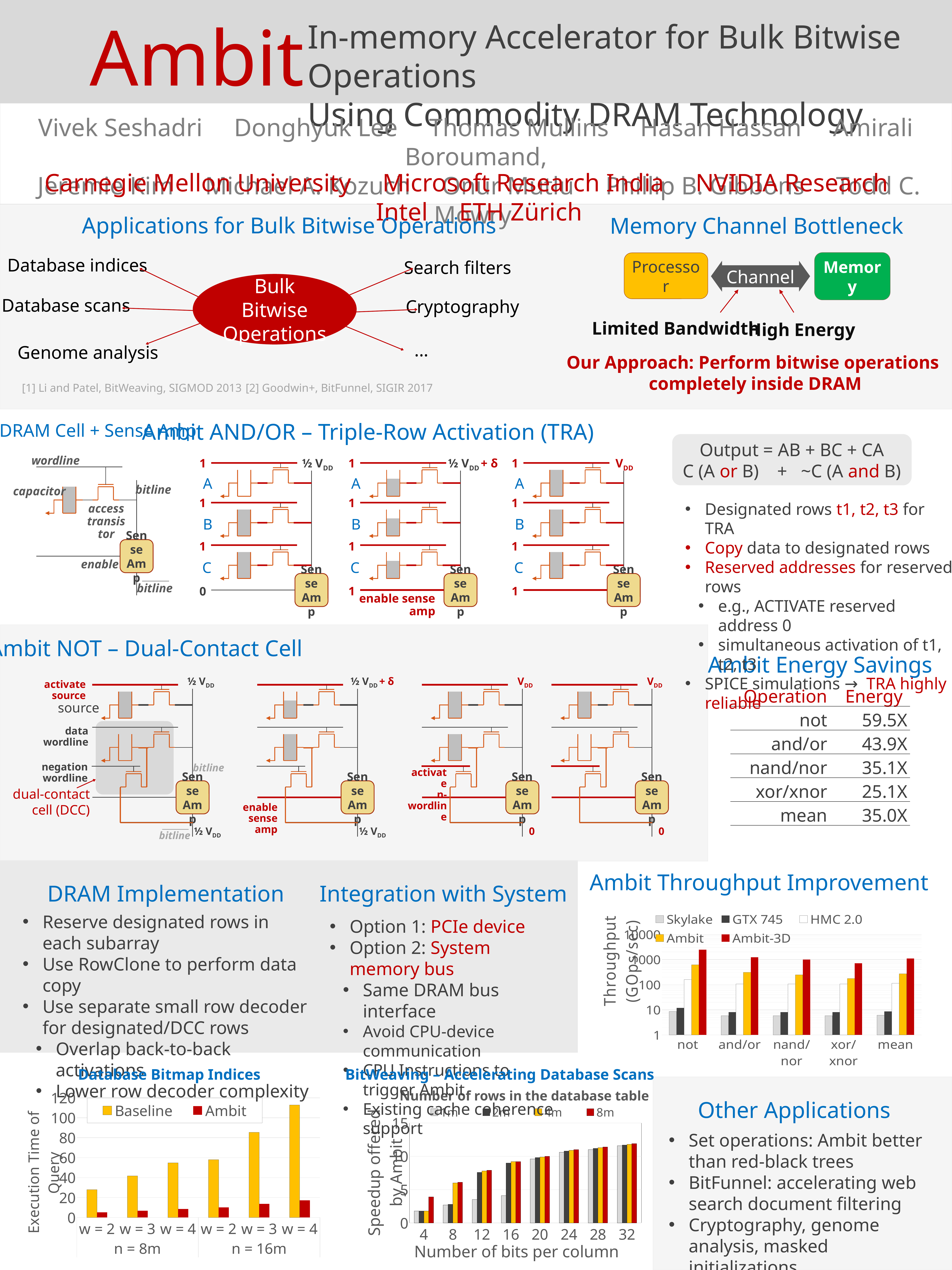
How many series does the legend of the 'BitWeaving – Accelerating Database Scans' chart list? 4 In the 'Ambit Throughput Improvement' chart, which is larger for 'and/or': Ambit or GTX 745? Ambit How many categories are shown on the x axis of the 'Ambit Throughput Improvement' chart? 5 In the 'Ambit Throughput Improvement' chart, is the Ambit-3D value for 'not' greater or less than 1000? greater In the 'BitWeaving – Accelerating Database Scans' chart, is the 8m speedup at 32 bits per column greater or less than 10? greater What kind of chart is the 'Ambit Throughput Improvement' chart? bar chart In the 'Ambit Throughput Improvement' chart, is the Skylake value for 'mean' greater or less than 10? less How many series does the legend of the 'Ambit Throughput Improvement' chart list? 5 In the 'Ambit Throughput Improvement' chart, which series has the highest throughput for 'not'? Ambit-3D In the 'Database Bitmap Indices' chart, which series has the lower execution time for w = 2 at n = 8m? Ambit In the 'Database Bitmap Indices' chart, does the Baseline execution time rise or fall as w increases from 2 to 4 for n = 16m? rises